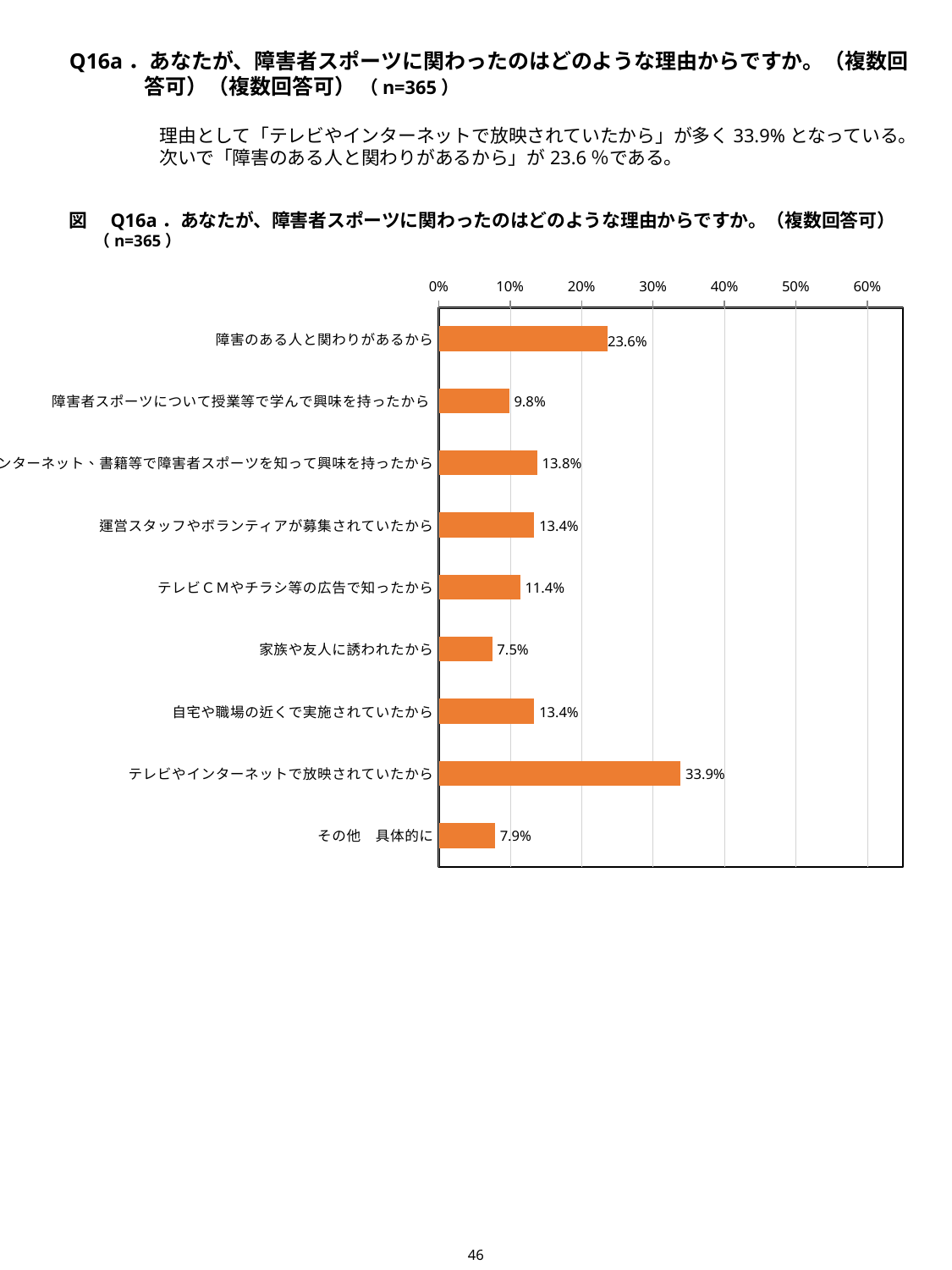
What is the value for 障害のある人と関わりがあるから? 23.6% Which category has the highest value? テレビやインターネットで放映されていたから What is the value for その他 具体的に? 7.9% Is the value for テレビやインターネットで放映されていたから greater or less than 30%? greater Which category has the lowest value? 家族や友人に誘われたから What is the value for テレビやインターネットで放映されていたから? 33.9% What kind of chart is shown on the slide? bar chart What is the difference between the values for テレビやインターネットで放映されていたから and 障害のある人と関わりがあるから? 10.3 percentage points Which is larger: the value for 障害者スポーツについて授業等で学んで興味を持ったから or the value for テレビＣＭやチラシ等の広告で知ったから? テレビＣＭやチラシ等の広告で知ったから What is the sample size (n) stated in the chart title? 365 What is the value for 運営スタッフやボランティアが募集されていたから? 13.4% How many categories are shown in the chart? 9